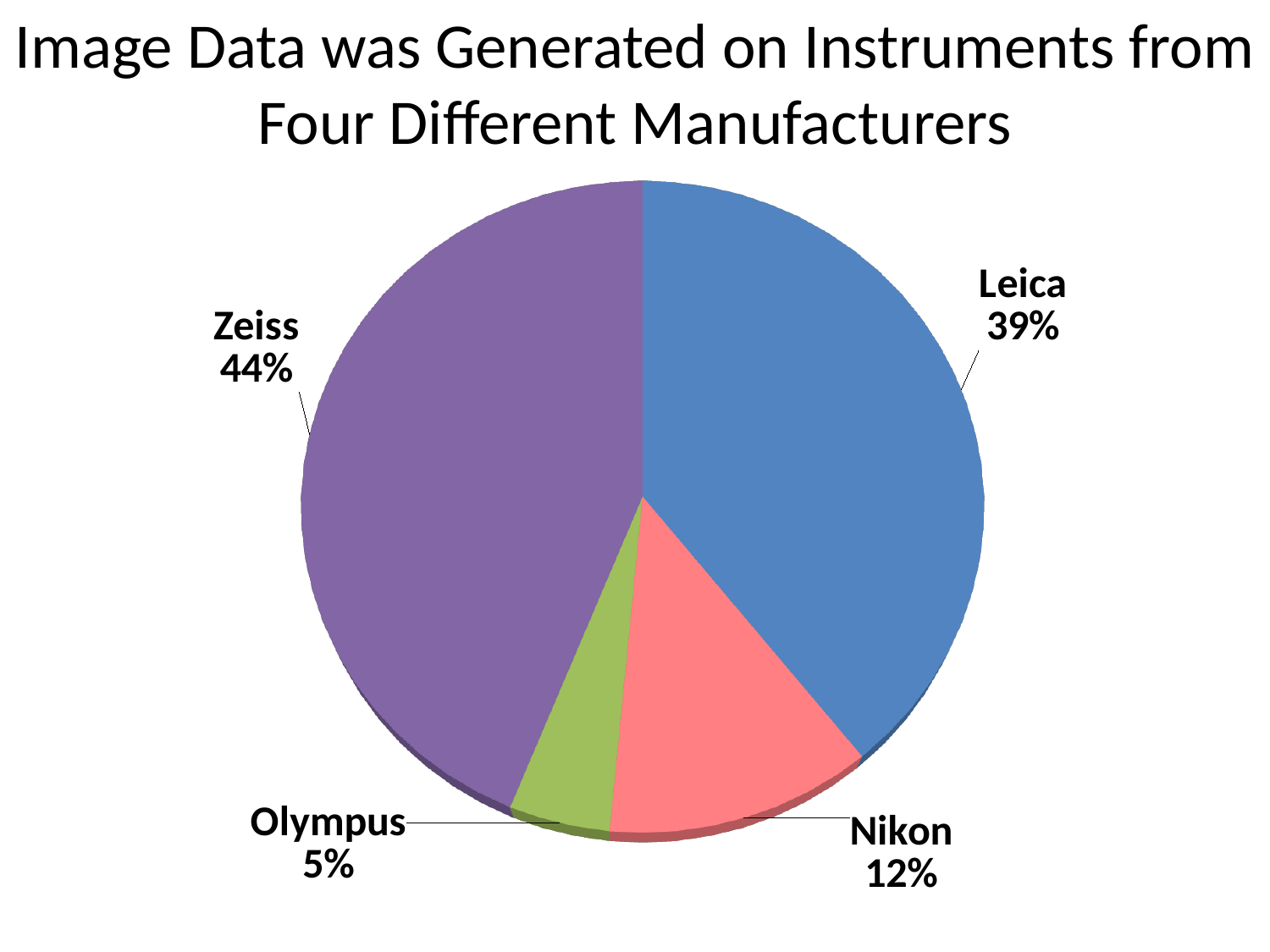
Which has a larger share, Nikon or Olympus? Nikon What share of the pie does Olympus have? 5% What share of the pie does Zeiss have? 44% What is the title of the chart? Image Data was Generated on Instruments from Four Different Manufacturers Which manufacturer has the largest slice of the pie? Zeiss What share of the pie does Nikon have? 12% Which manufacturer has the smallest slice of the pie? Olympus What type of chart is shown on the slide? pie chart How many slices does the pie chart have? 4 What is the difference in percentage points between Zeiss and Leica? 5 What is the difference in percentage points between Nikon and Olympus? 7